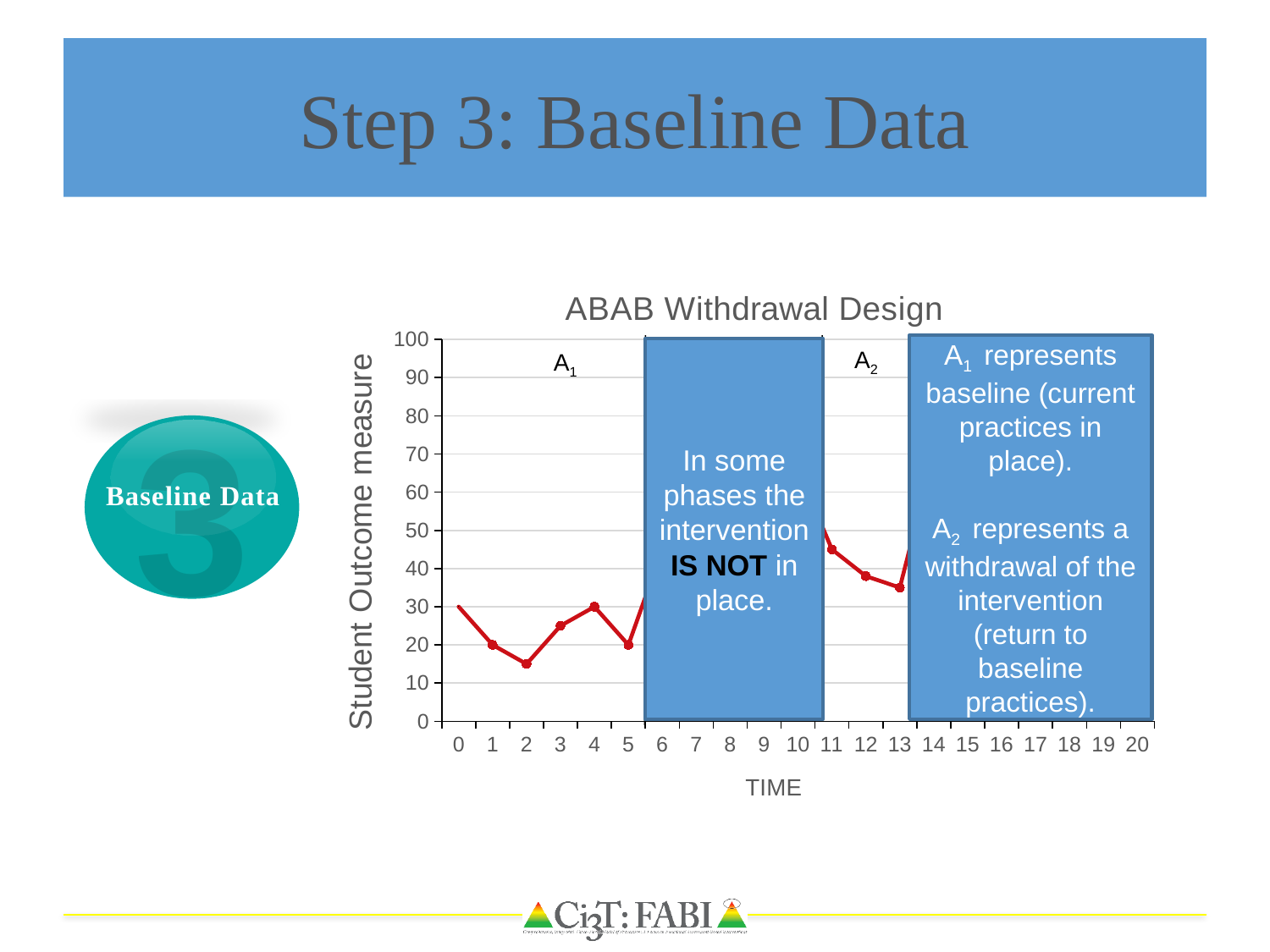
Is the value at time 13 greater or less than 40? less Do the values rise or fall from time 11 to time 13? fall What is the label of the vertical axis of the chart? Student Outcome measure Is the value at time 4 greater or less than 20? greater Is the value at time 11 greater or less than 40? greater Do the values rise or fall from time 2 to time 4? rise What kind of chart is shown on the slide? line chart What is the title of the chart? ABAB Withdrawal Design Which is larger, the value at time 2 or the value at time 4? time 4 Which is larger, the value at time 11 or the value at time 5? time 11